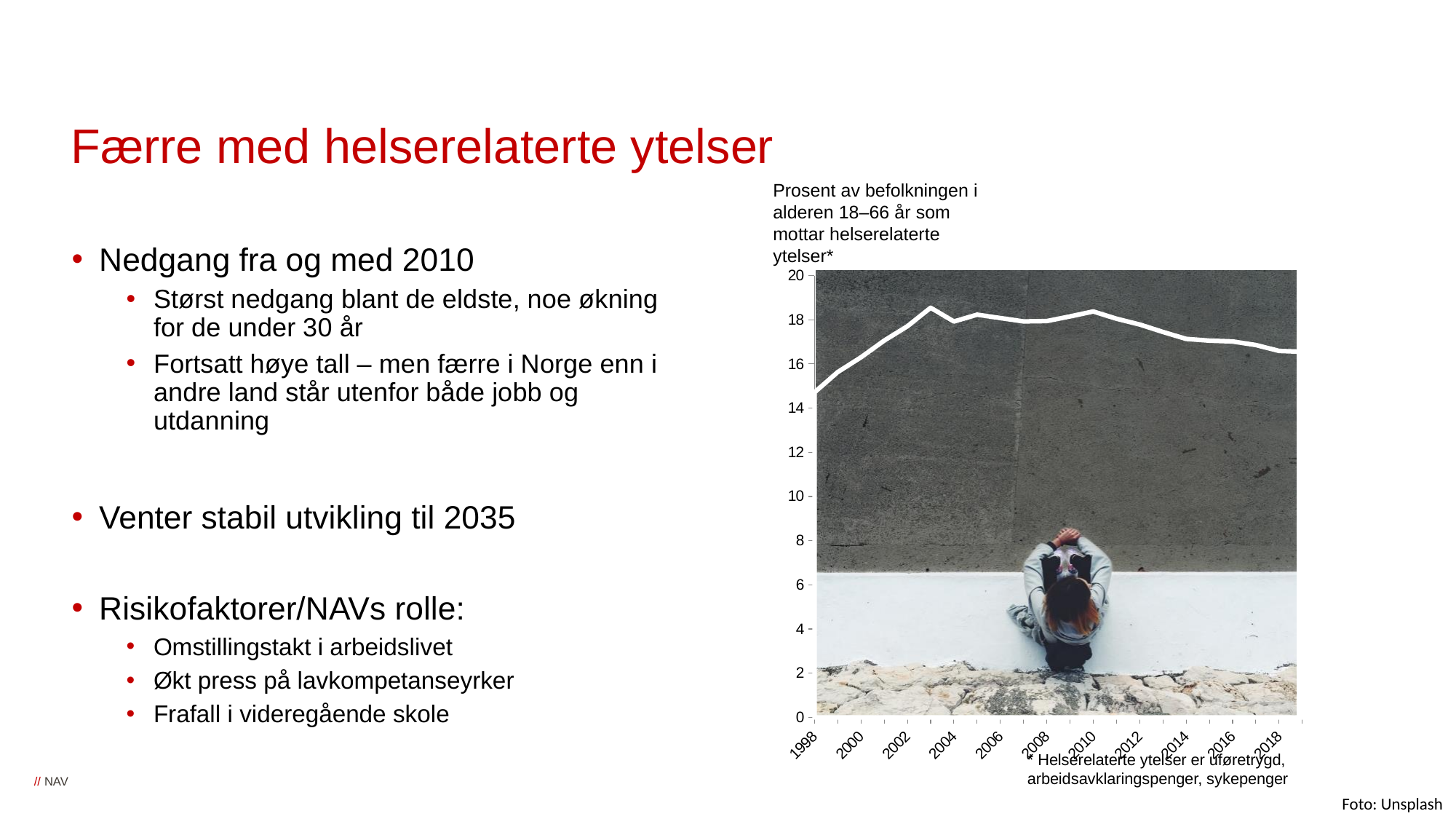
Is the value for 2010 greater or less than 18? greater What is the highest value shown on the y axis of the chart? 20 Do the values rise or fall from 1998 to 2003? rise Do the values rise or fall from 2010 to 2018? fall Which year has the lowest value in the chart? 1998 Is the value for 2016 greater or less than 16? greater What is the title of the chart? Prosent av befolkningen i alderen 18–66 år som mottar helserelaterte ytelser* Is the value for 1998 greater or less than 16? less Which is larger, the value for 1998 or the value for 2018? 2018 What kind of chart is shown on the slide? line chart